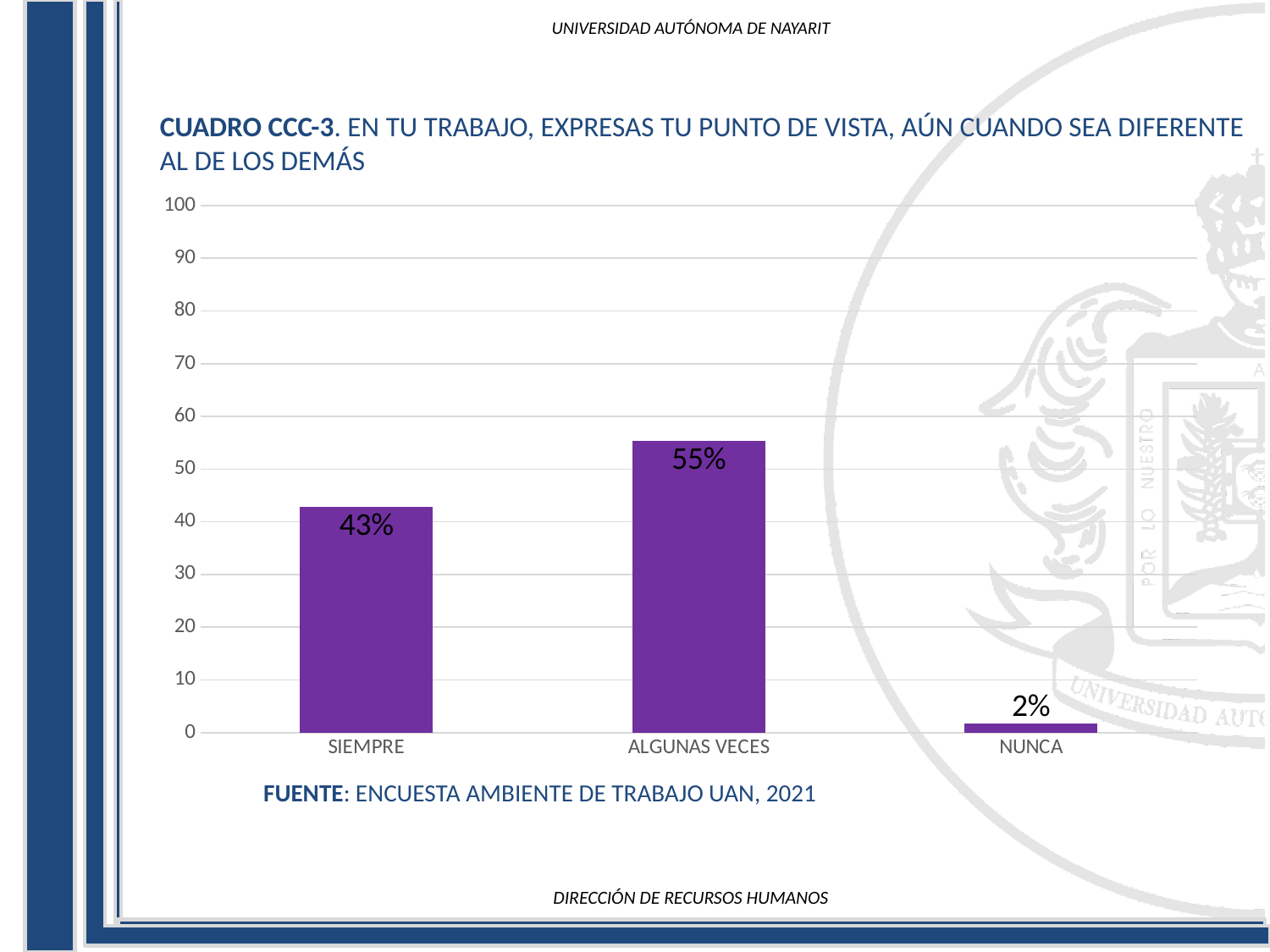
How many categories are shown on the x axis? 3 What colour are the bars in the chart? purple What is the value for SIEMPRE? 43% What kind of chart is shown on the slide? bar chart Is the value for SIEMPRE greater or less than 50? less Which category has the highest value? ALGUNAS VECES What is the source cited below the chart? ENCUESTA AMBIENTE DE TRABAJO UAN, 2021 Which is larger, the value for SIEMPRE or the value for NUNCA? SIEMPRE What is the value for NUNCA? 2% What is the value for ALGUNAS VECES? 55% What is the difference between the values for ALGUNAS VECES and SIEMPRE? 12% Which category has the lowest value? NUNCA